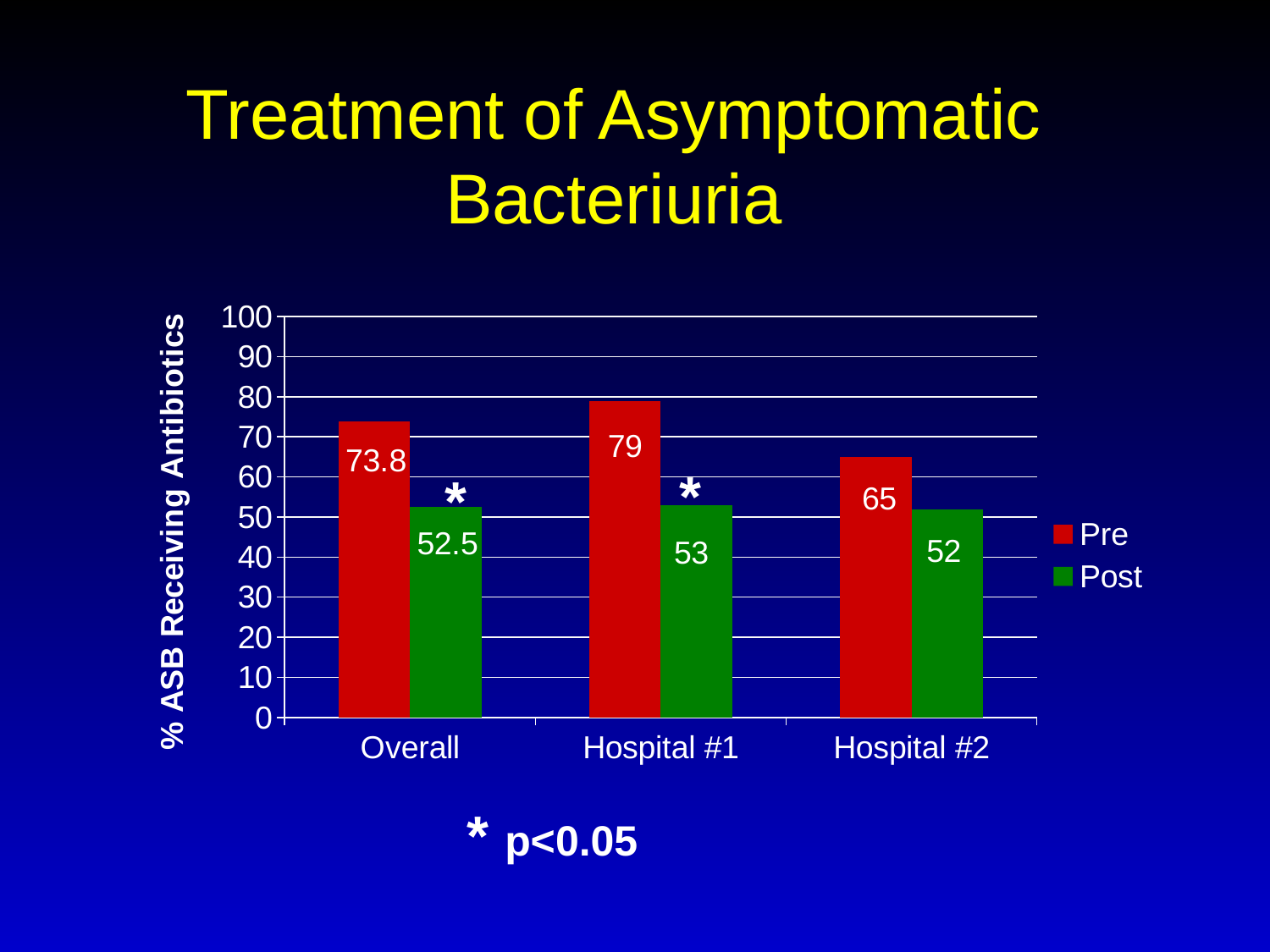
How many categories are shown on the x axis? 3 What kind of chart is shown on the slide? Bar chart What is the Pre value for Overall? 73.8 What is the difference between the Pre and Post values for Hospital #1? 26 What is the Pre value for Hospital #2? 65 Which is larger for Hospital #2, the Pre value or the Post value? Pre Which category has the highest Pre value? Hospital #1 What is the Post value for Overall? 52.5 What is the Post value for Hospital #1? 53 What is the difference between the Pre and Post values for Overall? 21.3 How many series does the legend list? 2 Which category has the lowest Pre value? Hospital #2